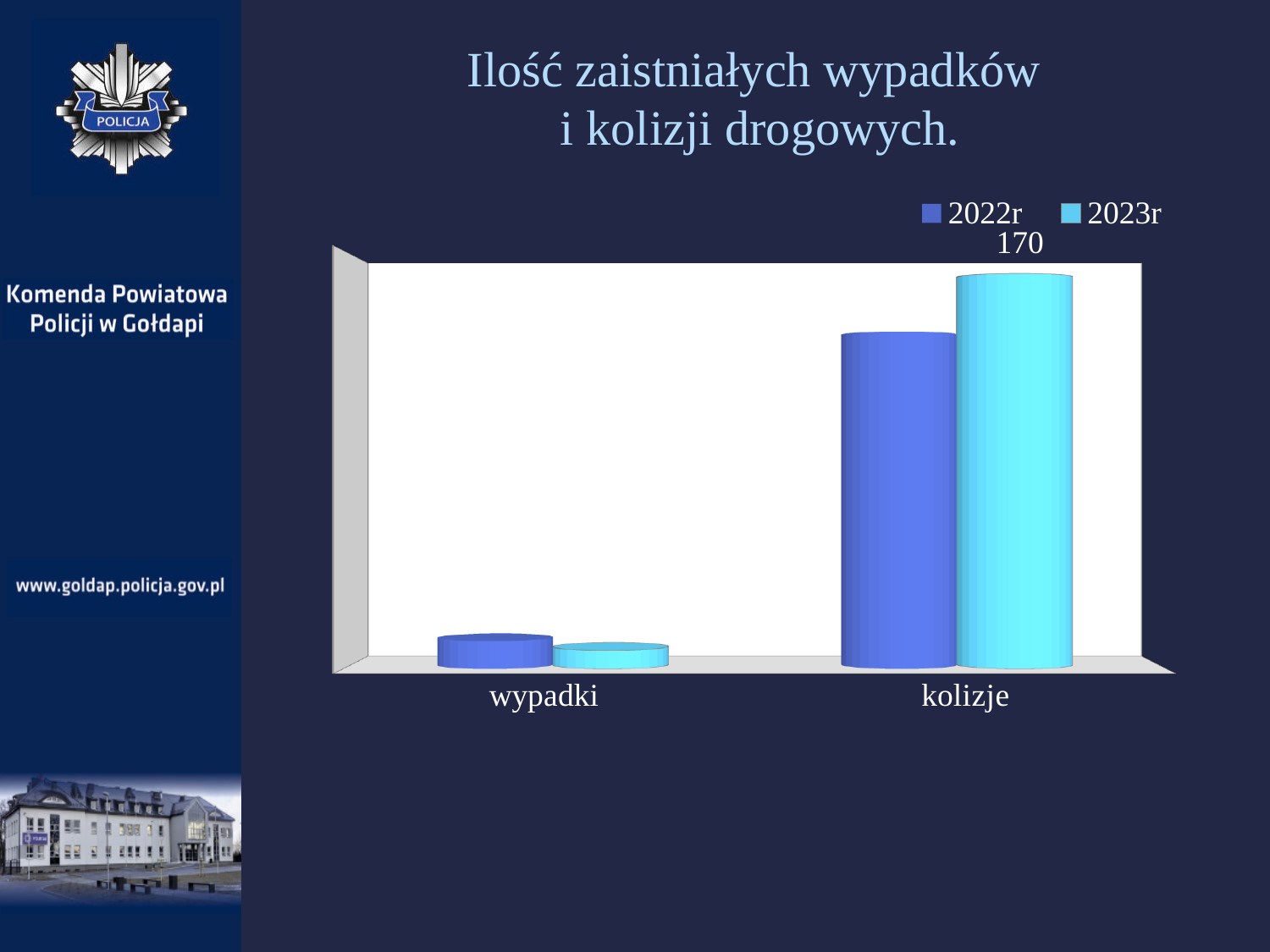
How many categories are shown on the x axis? 2 For kolizje, which year has the larger value, 2022r or 2023r? 2023r What is the title of the chart? Ilość zaistniałych wypadków i kolizji drogowych. How many series does the legend list? 2 What kind of chart is shown on the slide? bar chart What is the value for kolizje in 2023r? 170 What are the two series named in the legend? 2022r and 2023r Is the value for kolizje in 2022r larger or smaller than the value for wypadki in 2022r? larger Which category has the highest bar in the chart? kolizje Which series and category combination has the tallest bar? kolizje, 2023r Which category has the lowest bars in the chart? wypadki For wypadki, which year has the larger value, 2022r or 2023r? 2022r